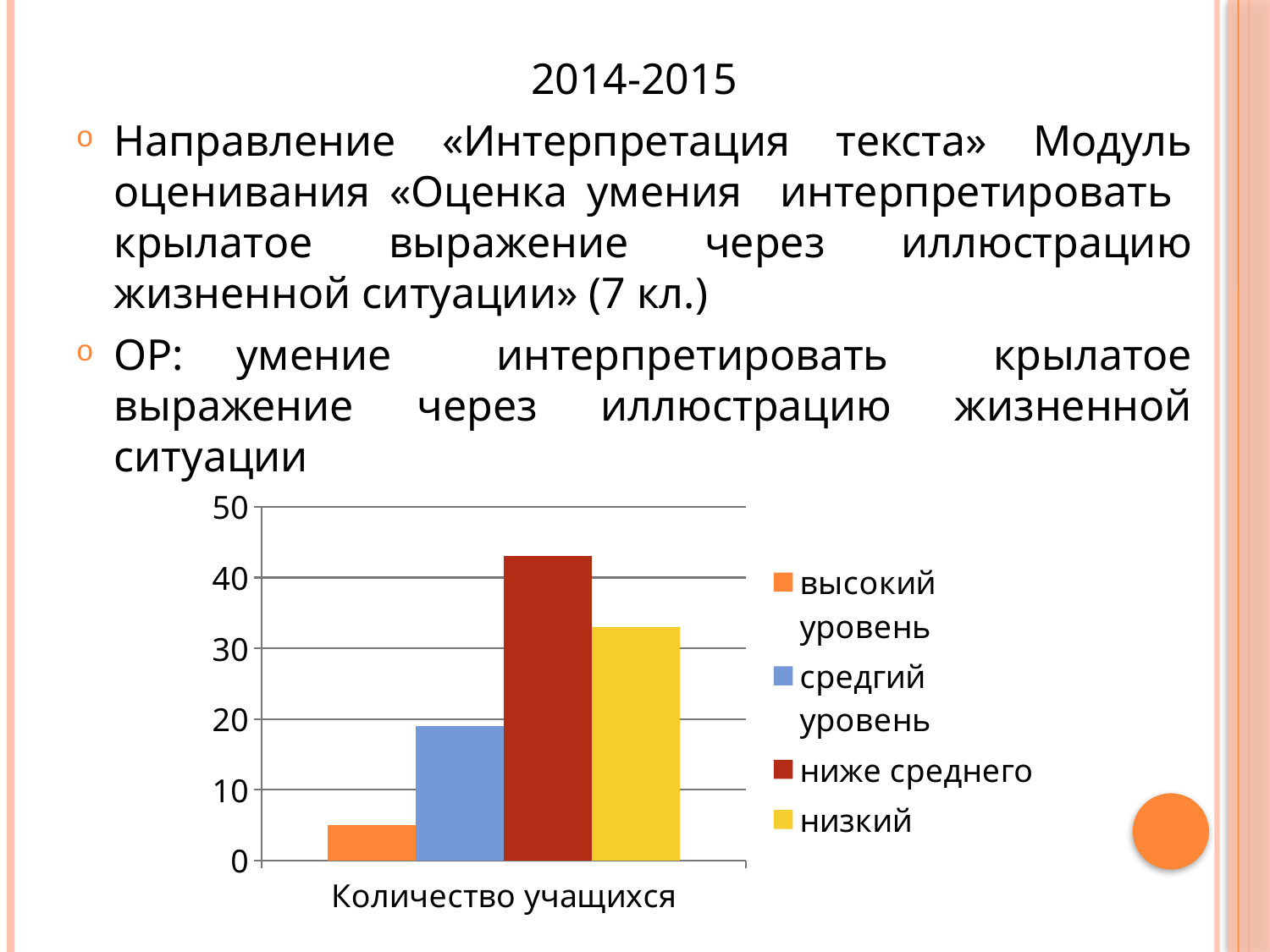
How many categories are shown on the x axis of the chart? 1 What is the category label shown on the x axis of the chart? Количество учащихся Is the value for высокий уровень greater or less than 10? less Which series has the highest bar in the chart? ниже среднего What kind of chart is shown on the slide? bar chart Which is larger, the value for низкий or the value for средгий уровень? низкий Is the value for низкий greater or less than 30? greater Which series has the lowest bar in the chart? высокий уровень What colour is the bar for ниже среднего in the chart? dark red Is the value for ниже среднего greater or less than 40? greater How many series does the chart legend list? 4